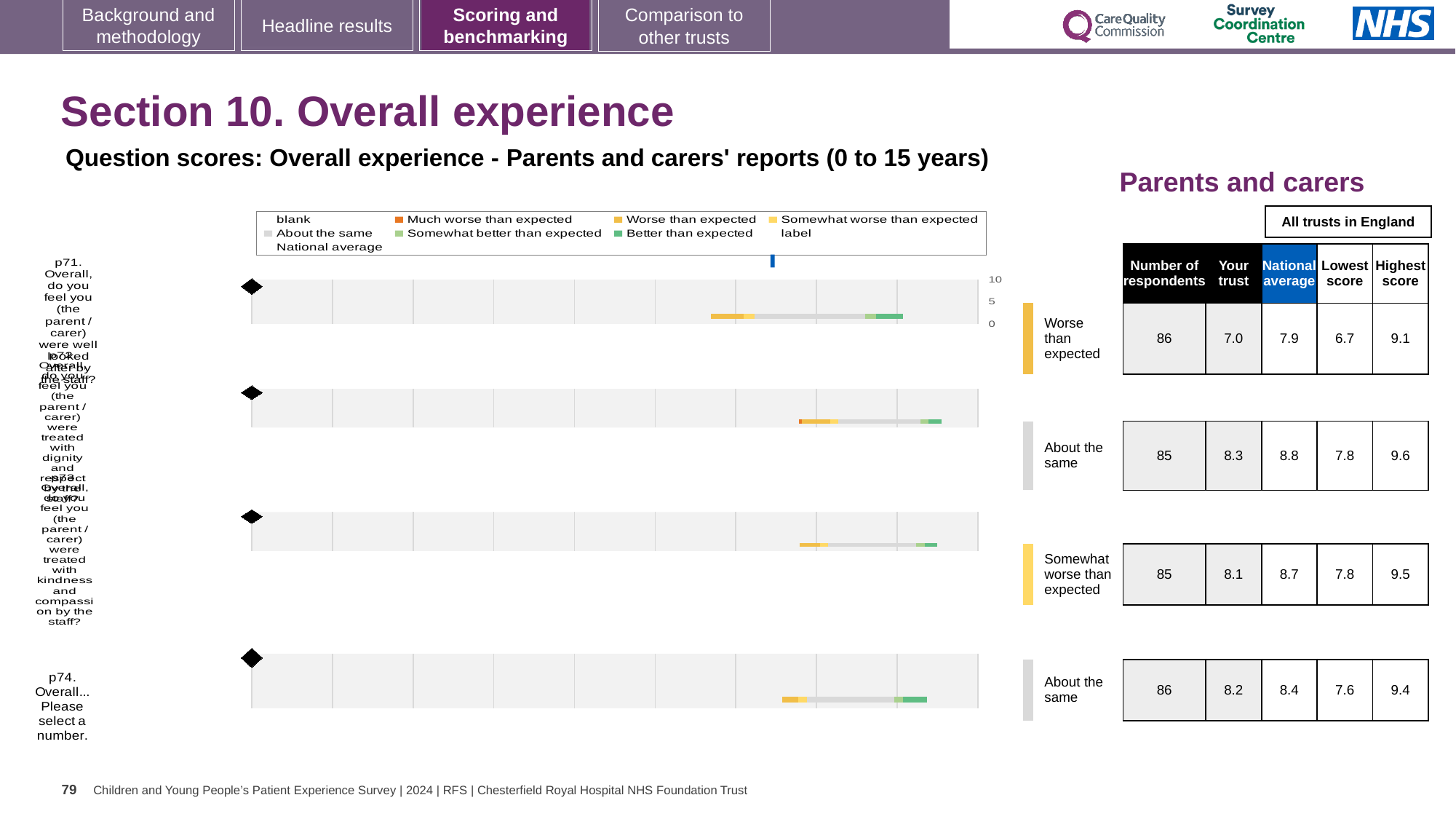
How many respondents answered question p72 (treated with dignity and respect by the staff)? 85 What is the national average score for question p74 (Overall... Please select a number)? 8.4 How many questions are plotted in the chart? 4 What benchmark category is shown for question p73? Somewhat worse than expected Which of the four questions has the highest 'Your trust' score? p72 What benchmark category is shown for question p71? Worse than expected What is the difference between the national average and the 'Your trust' score for question p71? 0.9 Is the 'Your trust' score for question p72 higher or lower than the national average for that question? lower What is the 'Your trust' score for question p71 (Overall, do you feel you were well looked after by the staff)? 7.0 What is the highest score across all trusts in England for question p73 (treated with kindness and compassion by the staff)? 9.5 Which of the four questions has the lowest 'Your trust' score? p71 What is the lowest score across all trusts in England for question p74? 7.6